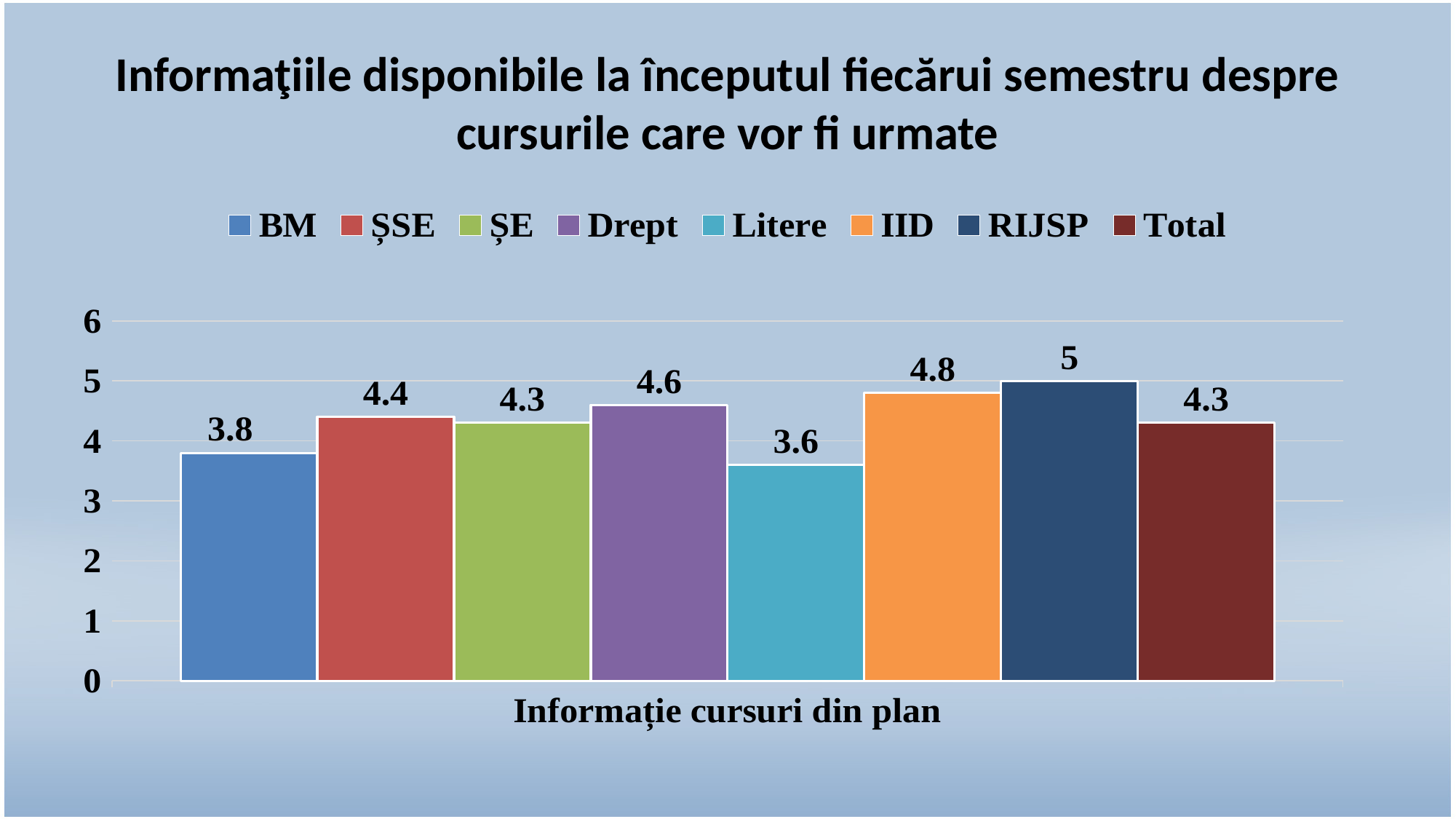
What is the value for RIJSP? 5 What kind of chart is shown on the slide? bar chart What is the difference between the values for IID and BM? 1 How many series does the legend list? 8 What is the value for BM? 3.8 What is the value for Total? 4.3 Which is larger, the value for Drept or the value for ȘSE? Drept What is the label on the x axis of the chart? Informație cursuri din plan Which series has the highest value? RIJSP What is the value for Litere? 3.6 Which series has the lowest value? Litere Is the value for IID greater or less than 4? greater